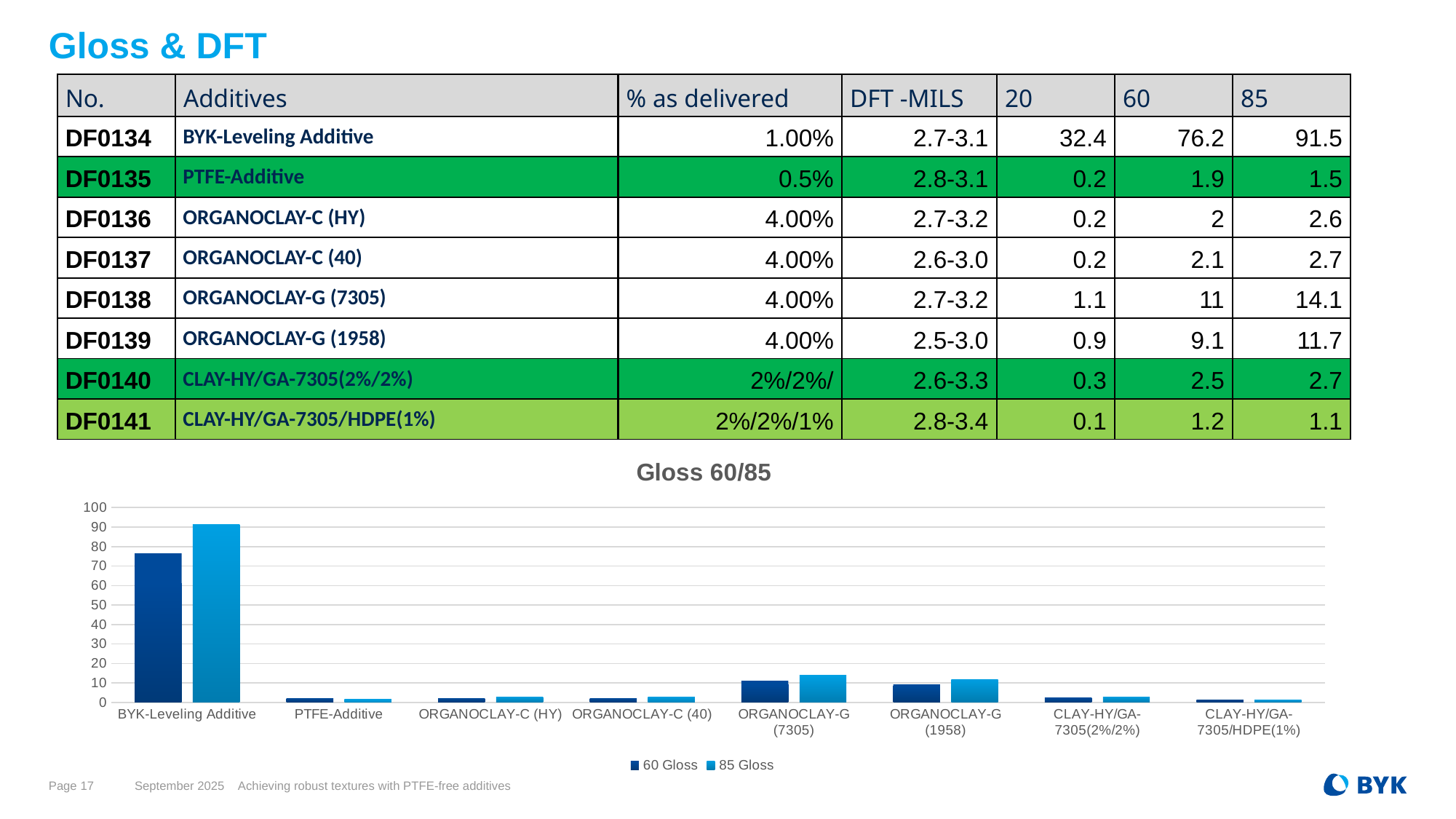
Which is larger for BYK-Leveling Additive in the "Gloss 60/85" chart: 60 Gloss or 85 Gloss? 85 Gloss Using the table values, what is the difference between the 85 gloss and 60 gloss values for BYK-Leveling Additive? 15.3 Is the 85 Gloss value for ORGANOCLAY-G (7305) greater or less than 20? less How many additive categories are plotted along the x axis of the "Gloss 60/85" chart? 8 How many series does the legend of the "Gloss 60/85" chart list? 2 According to the table, what is the 85 gloss value for BYK-Leveling Additive? 91.5 What kind of chart is shown under the title "Gloss 60/85"? bar chart Which additive has the highest 85 Gloss value in the "Gloss 60/85" chart? BYK-Leveling Additive Which is larger in the "Gloss 60/85" chart: the 85 Gloss value for ORGANOCLAY-G (7305) or the 85 Gloss value for ORGANOCLAY-G (1958)? ORGANOCLAY-G (7305) According to the table, what is the 60 gloss value for ORGANOCLAY-G (7305)? 11 What are the two legend entries of the "Gloss 60/85" chart? 60 Gloss and 85 Gloss Is the 60 Gloss value for BYK-Leveling Additive greater or less than 70? greater